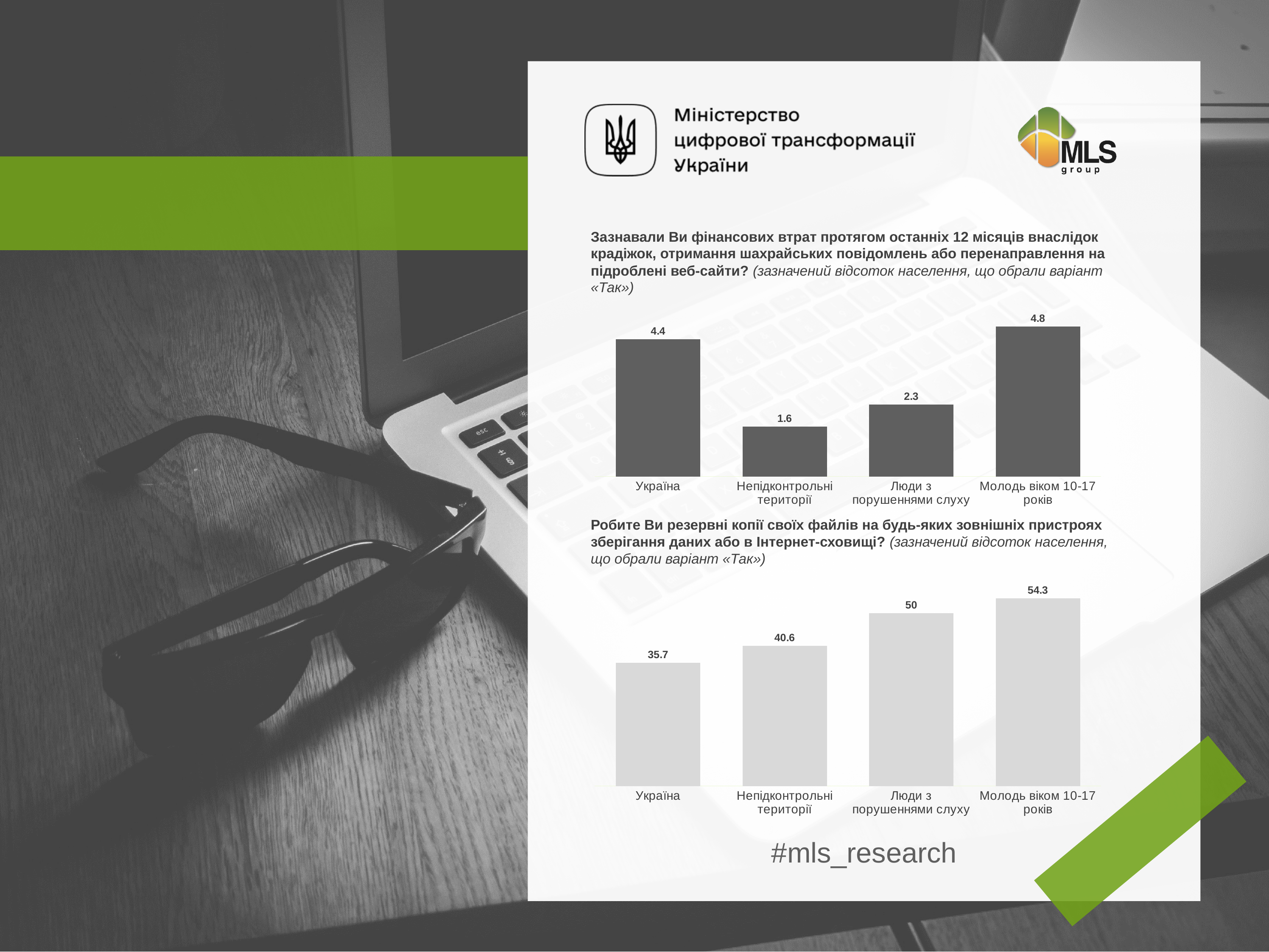
In the bottom chart (backing up files), what is the value for Непідконтрольні території? 40.6 In the bottom chart (backing up files), what is the value for Люди з порушеннями слуху? 50 In the bottom chart (backing up files), which category has the highest value? Молодь віком 10-17 років In the bottom chart (backing up files), which is larger: the value for Україна or the value for Непідконтрольні території? Непідконтрольні території What type of chart is the bottom chart (backing up files)? Bar chart In the top chart (financial losses in the last 12 months), which category has the highest value? Молодь віком 10-17 років In the top chart (financial losses in the last 12 months), which category has the lowest value? Непідконтрольні території In the top chart (financial losses in the last 12 months), how many categories are shown? 4 In the bottom chart (backing up files), which category has the lowest value? Україна In the top chart (financial losses in the last 12 months), what is the difference between the values for Молодь віком 10-17 років and Непідконтрольні території? 3.2 In the bottom chart (backing up files), what is the difference between the values for Молодь віком 10-17 років and Україна? 18.6 In the top chart (financial losses in the last 12 months), what is the value for Україна? 4.4